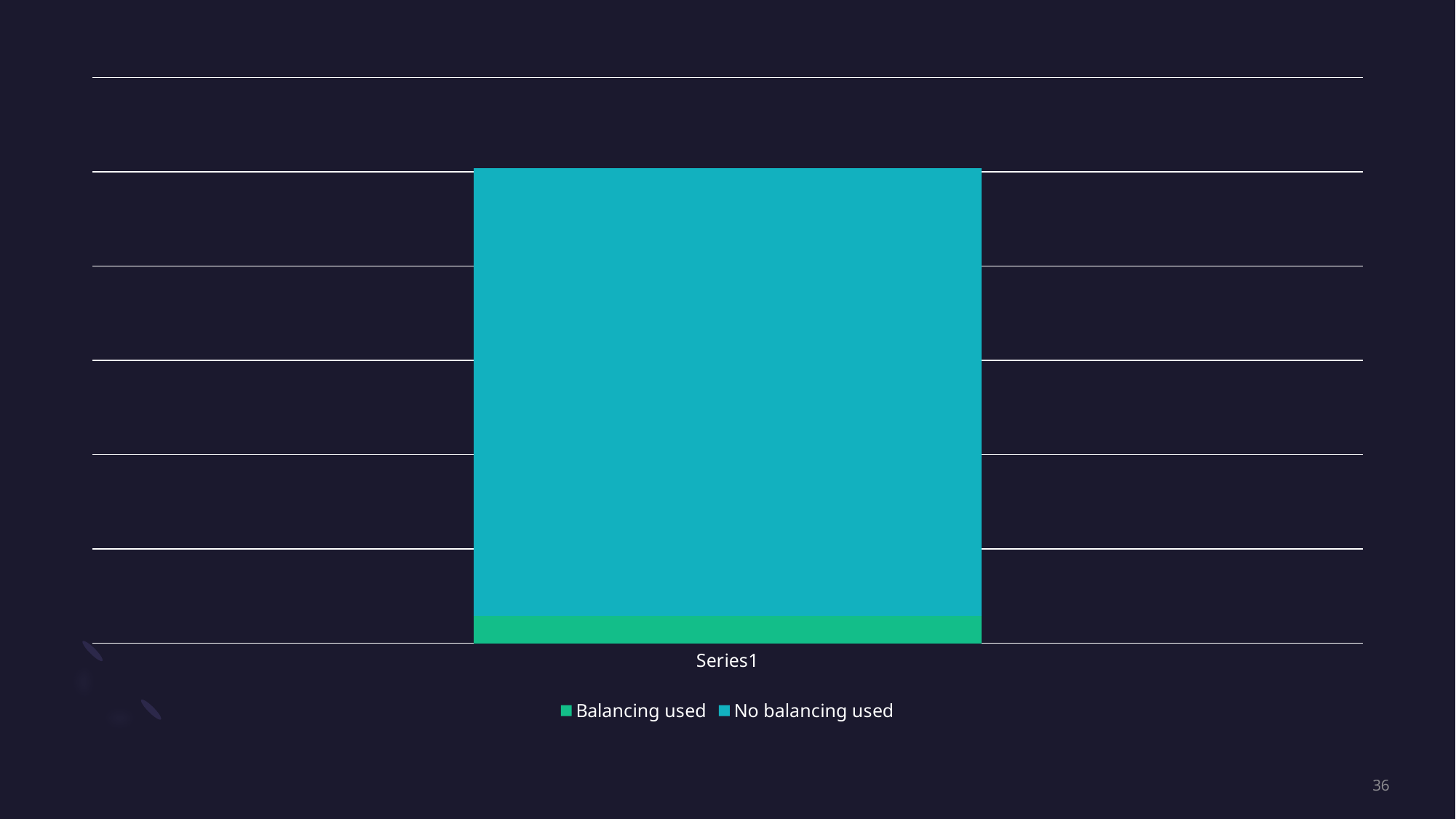
Which series takes up the larger part of the stacked bar, Balancing used or No balancing used? No balancing used How many series does the legend list? 2 What is the label of the single category on the x axis? Series1 What kind of chart is shown on the slide? bar chart Which series has the smallest segment in the stacked bar? Balancing used How many categories are plotted on the x axis? 1 Which series has the largest segment in the stacked bar? No balancing used What are the two series names listed in the legend? Balancing used, No balancing used